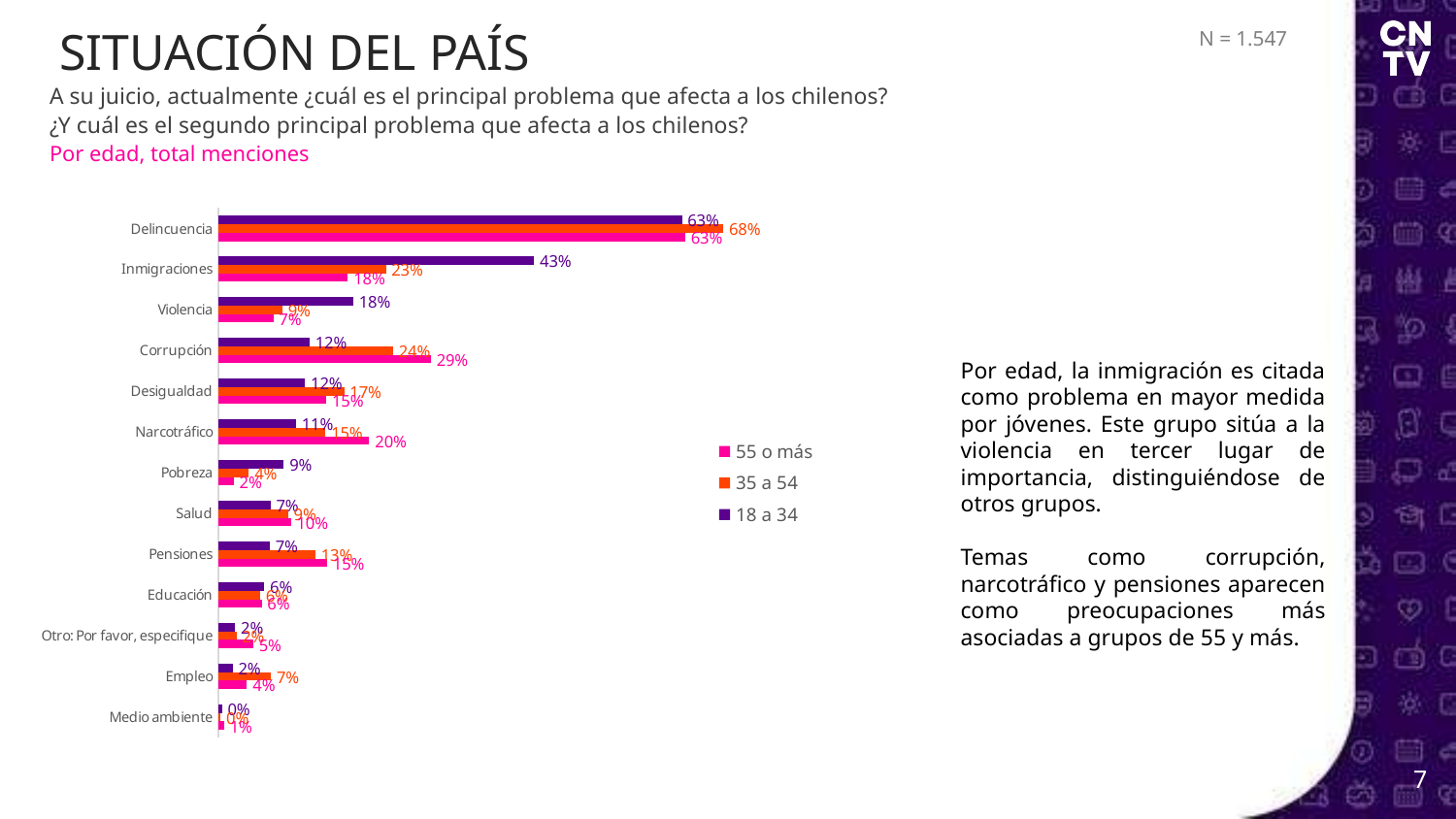
How many series does the legend list? 3 What is the difference between the 18 a 34 value and the 55 o más value for Inmigraciones? 25% What is the value for Narcotráfico in the 55 o más series? 20% Which category has the highest value in the 18 a 34 series? Delincuencia Which series is shown in pink in the legend? 55 o más What is the value for Delincuencia in the 35 a 54 series? 68% What is the value for Inmigraciones in the 18 a 34 series? 43% What kind of chart is shown on the slide? Bar chart How many categories are shown on the chart? 13 What is the value for Violencia in the 18 a 34 series? 18% For Corrupción, which series has the larger value: 18 a 34 or 55 o más? 55 o más What is the value for Corrupción in the 55 o más series? 29%